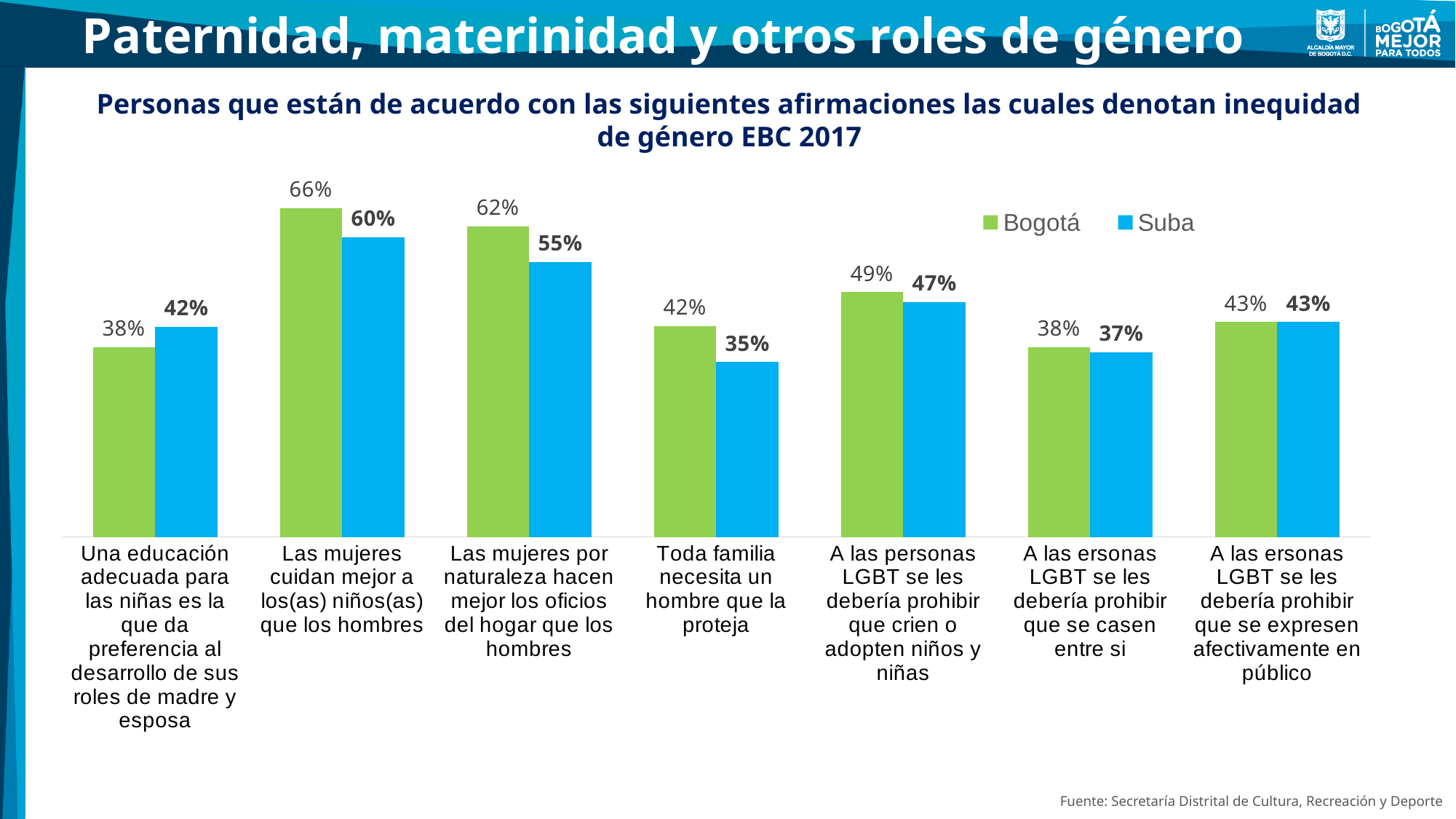
How many statements (categories) are shown on the x axis? 7 Which series is shown in green in the legend? Bogotá Which statement has the lowest Suba value? Toda familia necesita un hombre que la proteja What is the Bogotá value for "Las mujeres cuidan mejor a los(as) niños(as) que los hombres"? 66% What kind of chart is shown on the slide? Bar chart Which statement has the highest Bogotá value? Las mujeres cuidan mejor a los(as) niños(as) que los hombres For "Una educación adecuada para las niñas es la que da preferencia al desarrollo de sus roles de madre y esposa", which is larger, the Bogotá value or the Suba value? Suba What is the Suba value for "A las personas LGBT se les debería prohibir que crien o adopten niños y niñas"? 47% What is the Suba value for "Toda familia necesita un hombre que la proteja"? 35% What is the difference between the Bogotá and Suba values for "Las mujeres por naturaleza hacen mejor los oficios del hogar que los hombres"? 7% What is the Bogotá value for "A las ersonas LGBT se les debería prohibir que se casen entre si"? 38% How many series does the legend list? 2